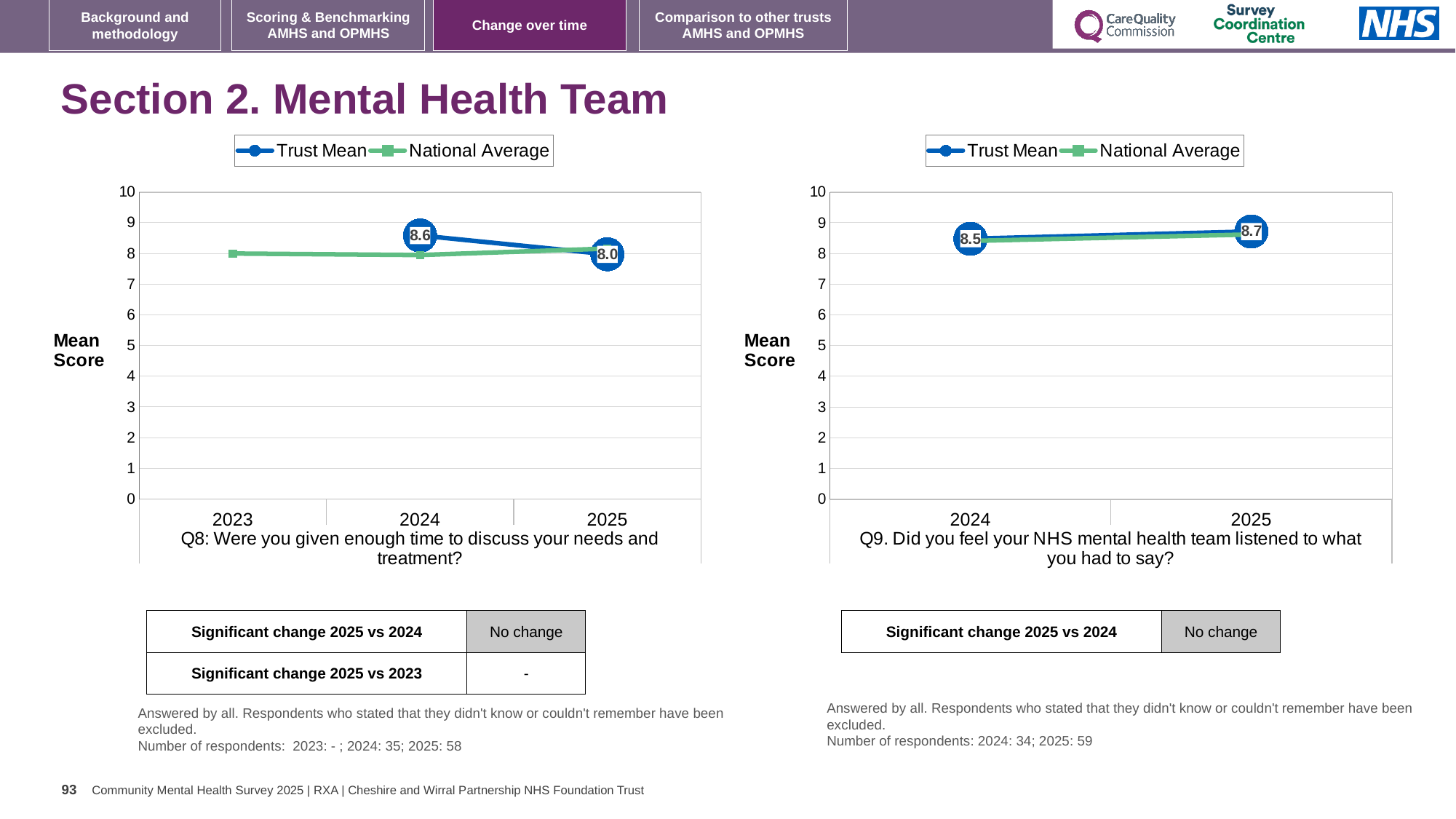
In the Q9 chart (right), what is the Trust Mean for 2025? 8.7 In the Q8 chart (left), is the National Average for 2023 greater or less than 5? greater In the Q9 chart (right), what is the Trust Mean for 2024? 8.5 In the Q9 chart (right), does the Trust Mean rise or fall from 2024 to 2025? rise How many years are shown on the x axis of the Q8 chart (left)? 3 What type of chart is the Q9 chart (right)? line chart How many series does the legend of the Q8 chart (left) list? 2 In the Q8 chart (left), what is the Trust Mean for 2025? 8.0 In the Q8 chart (left), does the Trust Mean rise or fall from 2024 to 2025? fall In the Q8 chart (left), what is the Trust Mean for 2024? 8.6 In the Q9 chart (right), what is the difference between the Trust Mean in 2025 and 2024? 0.2 In the Q8 chart (left), by how much did the Trust Mean change from 2024 to 2025? 0.6